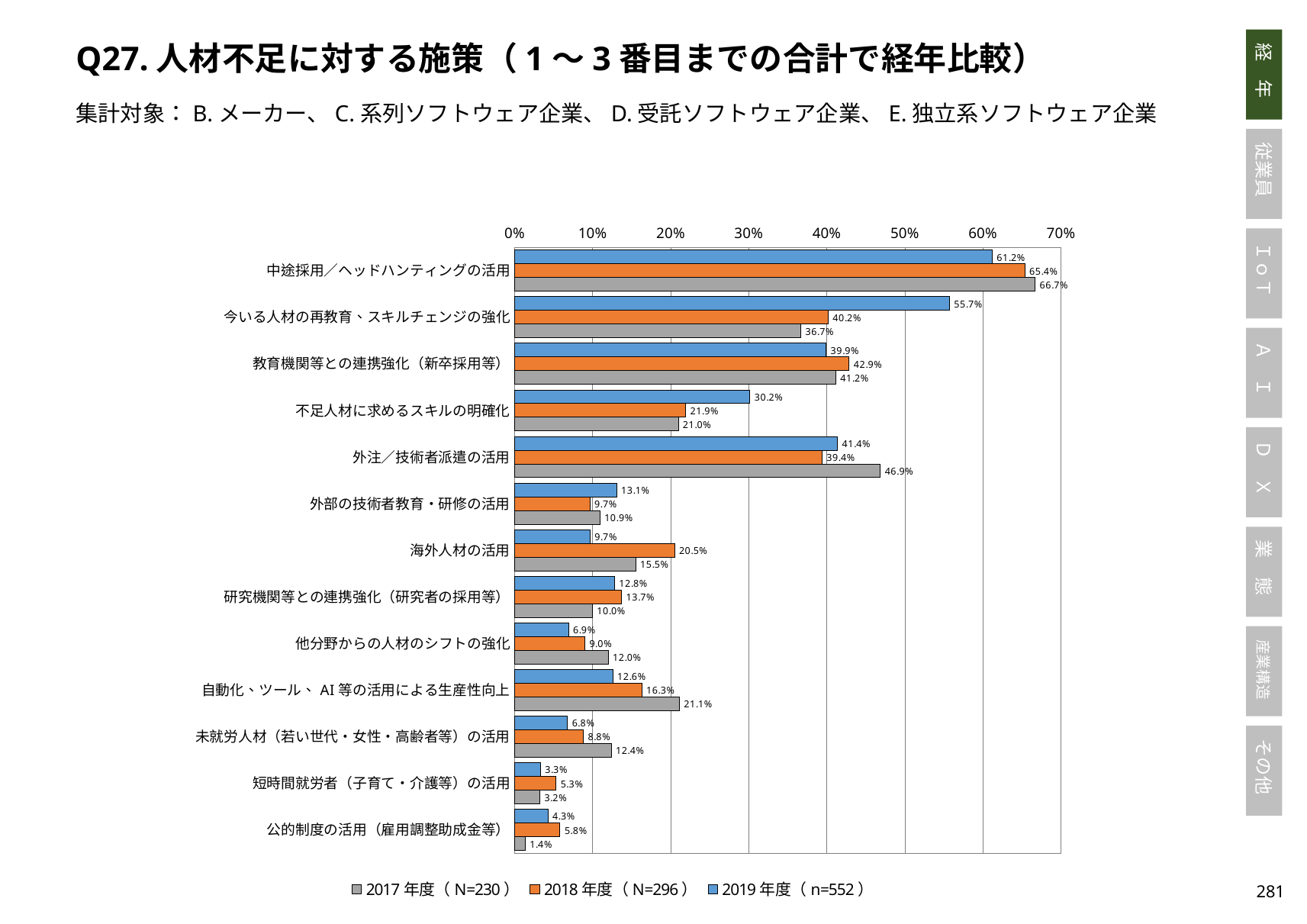
What is the difference between the 2019年度 and 2017年度 values for 今いる人材の再教育、スキルチェンジの強化? 19.0 percentage points What is the 2019年度 value for 中途採用／ヘッドハンティングの活用? 61.2% Is the 2019年度 value for 不足人材に求めるスキルの明確化 greater or less than 30%? greater For 自動化、ツール、AI等の活用による生産性向上, which is larger: the 2017年度 value or the 2019年度 value? 2017年度 Which category has the highest 2019年度 value? 中途採用／ヘッドハンティングの活用 How many series does the legend list? 3 What type of chart is shown on the slide? bar chart Which category has the lowest 2017年度 value? 公的制度の活用（雇用調整助成金等） What is the 2018年度 value for 海外人材の活用? 20.5% What is the sample size (N) shown in the legend for 2018年度? N=296 How many categories (施策) are plotted on the chart? 13 What is the 2017年度 value for 外注／技術者派遣の活用? 46.9%